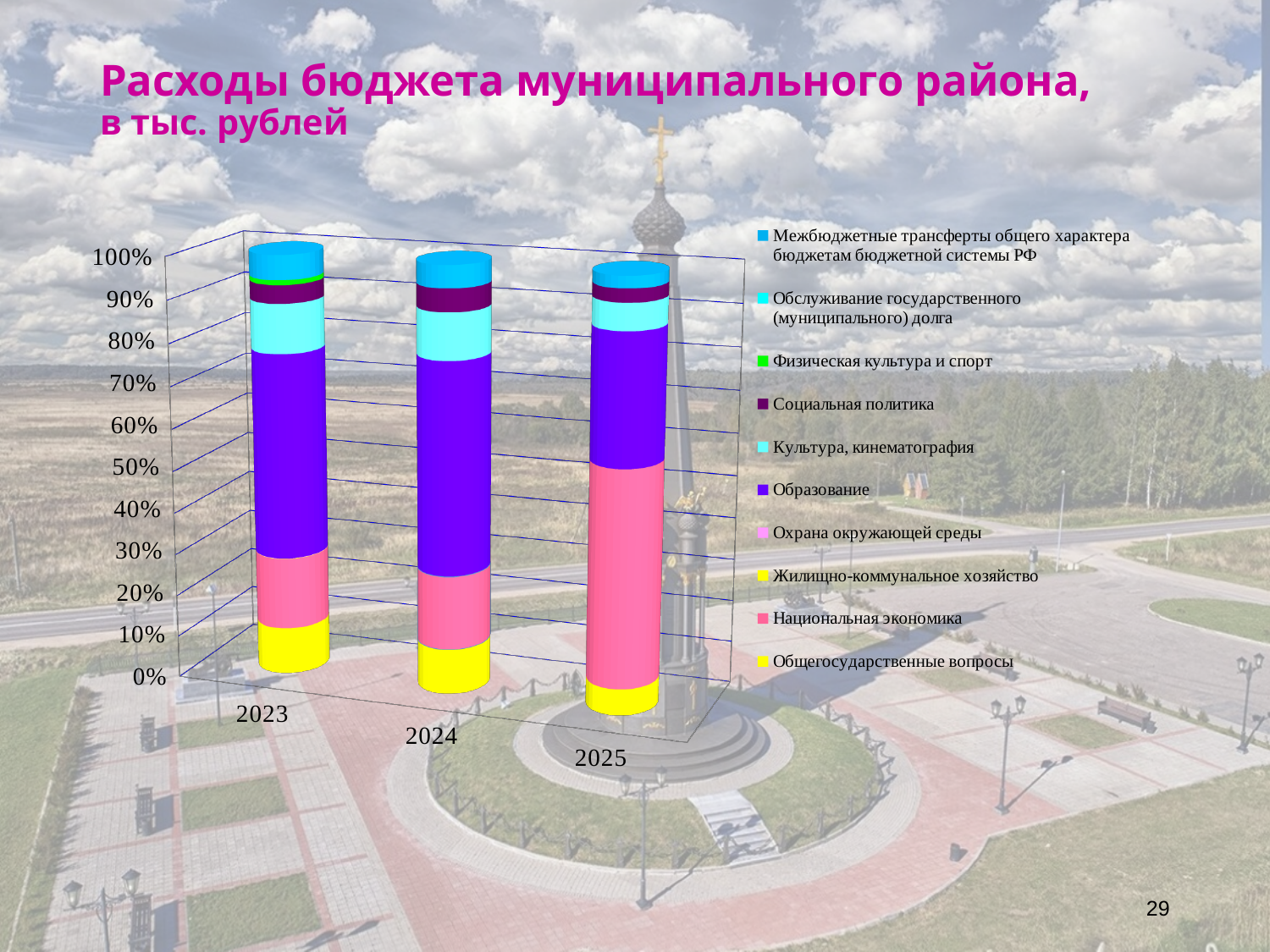
Is the share of Образование larger in 2023 or in 2025? 2023 In which year is the share of Национальная экономика the largest? 2025 Is the share of Общегосударственные вопросы in 2023 greater or less than 20%? less Does the share of Национальная экономика rise or fall from 2023 to 2025? rise Is the share of Национальная экономика in 2025 greater or less than 30%? greater What kind of chart is shown on the slide? stacked bar chart Is the share of Национальная экономика larger in 2025 or in 2023? 2025 What is the title of the chart on the slide? Расходы бюджета муниципального района, в тыс. рублей Is the share of Образование in 2023 greater or less than 40%? greater How many series does the chart legend list? 10 How many years are shown on the x axis of the chart? 3